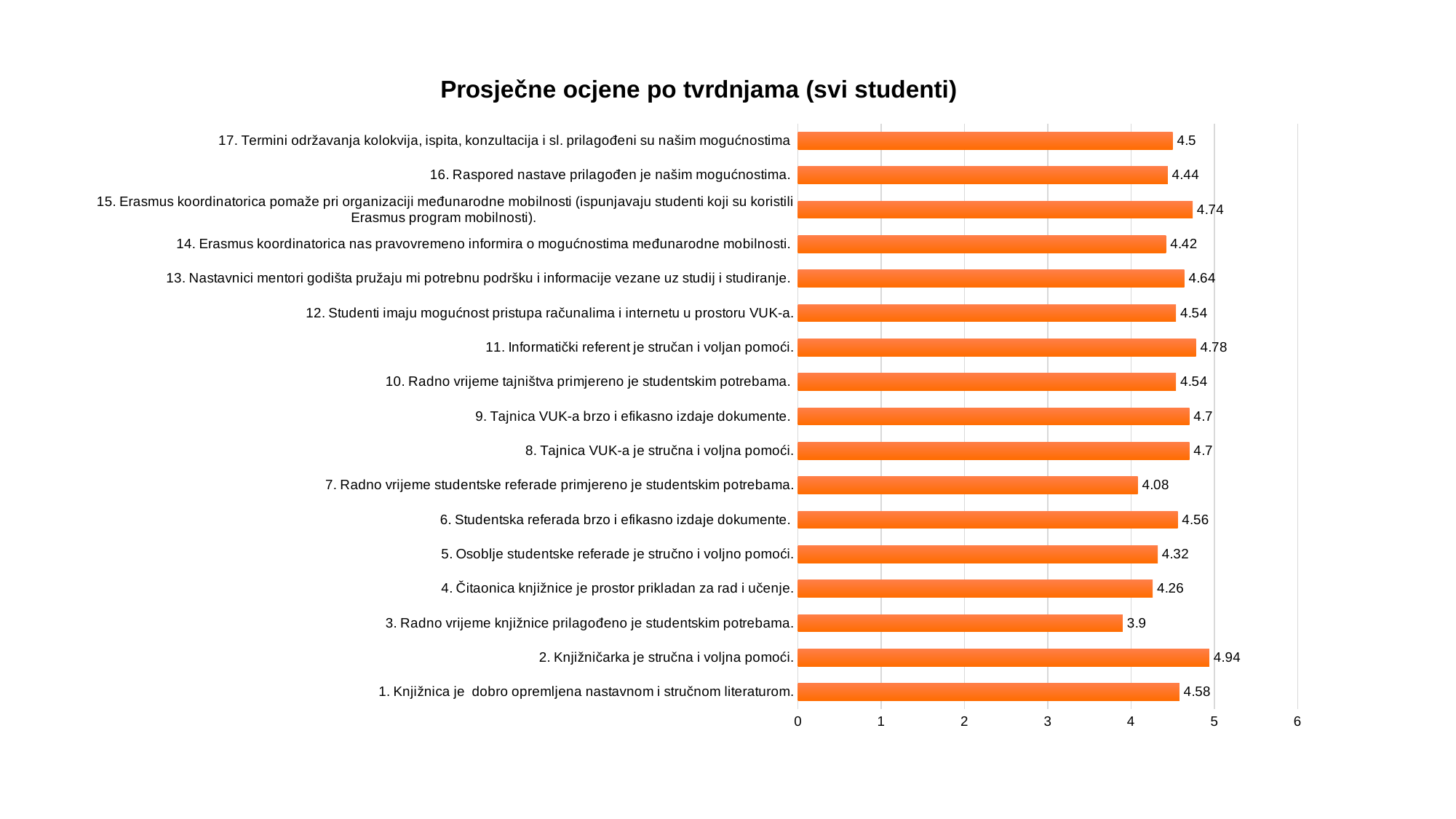
What is the average score for statement 2, "Knjižničarka je stručna i voljna pomoći."? 4.94 Which has a higher score: statement 7 (Radno vrijeme studentske referade) or statement 6 (Studentska referada brzo i efikasno izdaje dokumente)? 6. Studentska referada brzo i efikasno izdaje dokumente. What kind of chart is shown on the slide? bar chart What is the average score for statement 3, "Radno vrijeme knjižnice prilagođeno je studentskim potrebama."? 3.9 Which statement has the lowest average score? 3. Radno vrijeme knjižnice prilagođeno je studentskim potrebama. What is the title of the chart? Prosječne ocjene po tvrdnjama (svi studenti) What is the difference between the scores for statement 2 and statement 3? 1.04 What is the average score for statement 11, "Informatički referent je stručan i voljan pomoći."? 4.78 Which statement has the highest average score? 2. Knjižničarka je stručna i voljna pomoći. How many statements are plotted in the chart? 17 Is the value for statement 3 greater or less than 4? less What is the difference between the scores for statement 15 and statement 14? 0.32